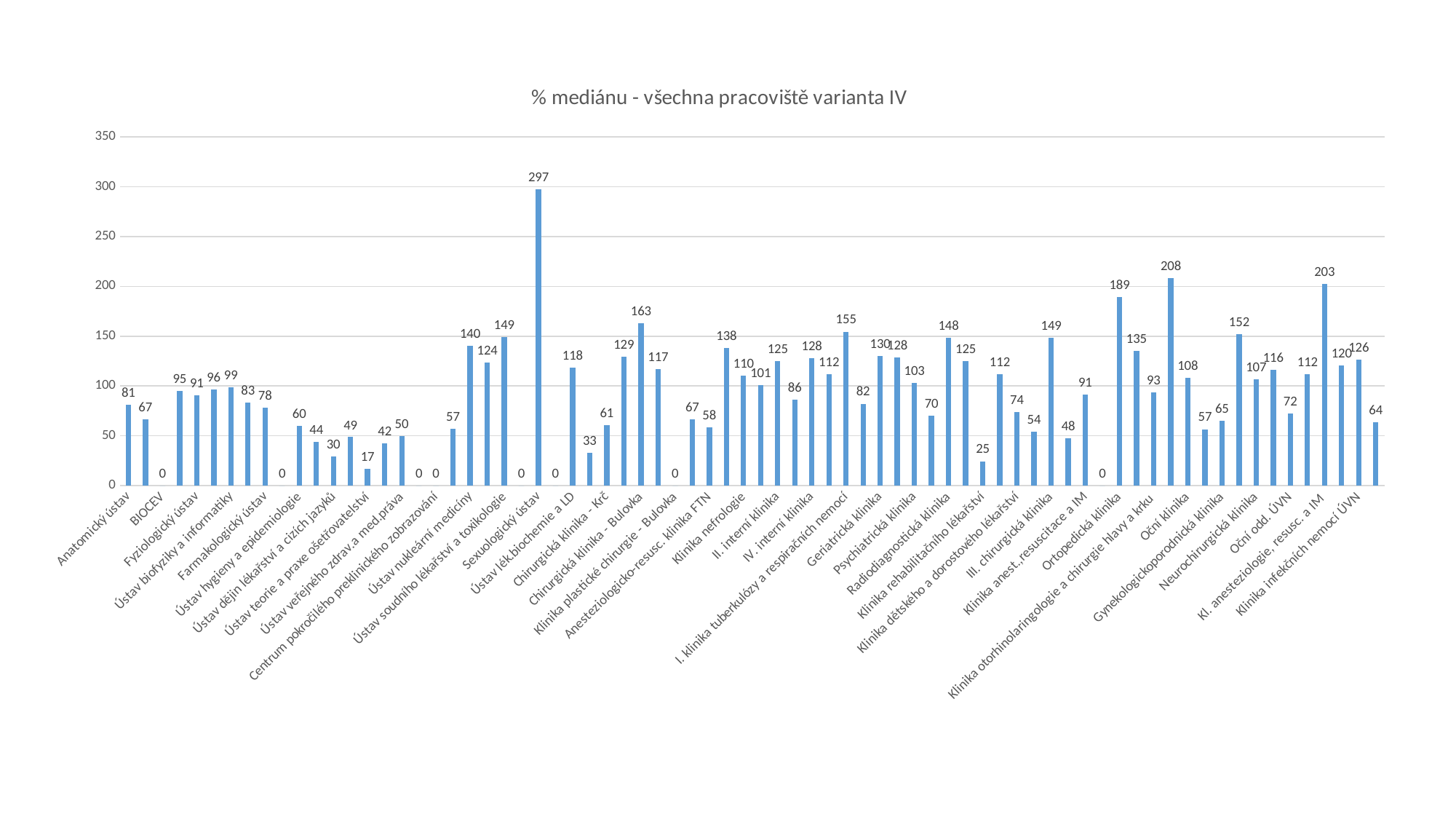
Is the value for Sexuologický ústav greater or less than 250? greater What is the value for Ortopedická klinika? 189 What is the highest value shown in the chart? 297 What is the value for Anatomický ústav? 81 What is the maximum value shown on the vertical axis? 350 What is the difference between the values for Sexuologický ústav (297) and Ortopedická klinika (189)? 108 What kind of chart is shown on the slide? bar chart Which is larger, the value for Kl. anesteziologie, resusc. a IM or the value for Klinika infekčních nemocí ÚVN? Kl. anesteziologie, resusc. a IM Which category has the highest value in the chart? Sexuologický ústav What is the title of the chart? % mediánu - všechna pracoviště varianta IV What is the value for Klinika rehabilitačního lékařství? 25 What is the value for Chirurgická klinika - Bulovka? 163